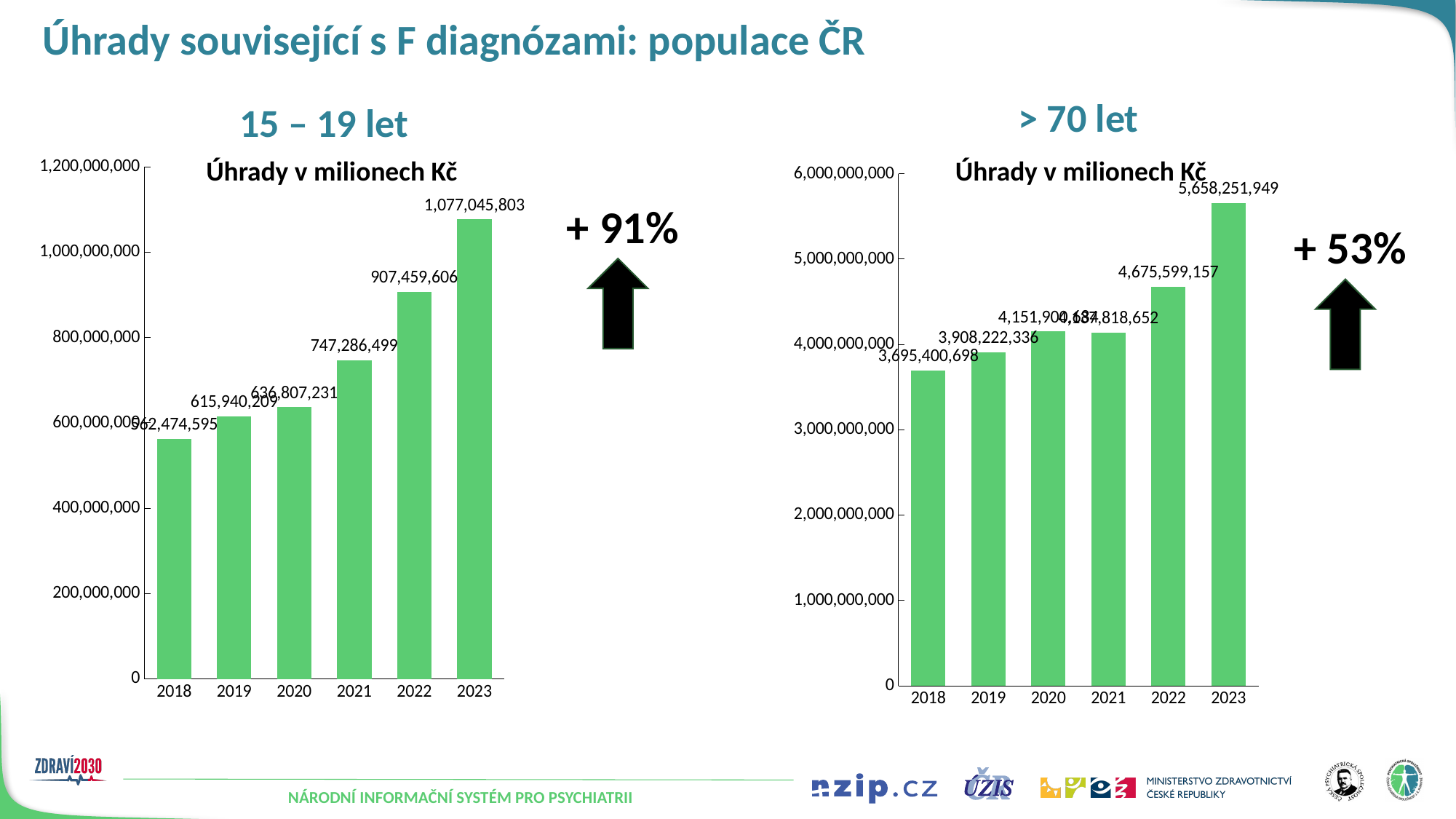
In the '> 70 let' chart, what is the value for 2019? 3,908,222,336 In the '15 – 19 let' chart, which is larger, the value for 2019 or the value for 2022? 2022 In the '> 70 let' chart, is the value for 2018 greater or less than 4,000,000,000? less In the '15 – 19 let' chart, what is the value for 2021? 747,286,499 How many years are shown on the x axis of the '15 – 19 let' chart? 6 In the '15 – 19 let' chart, what is the value for 2023? 1,077,045,803 In the '> 70 let' chart, what is the value for 2022? 4,675,599,157 In the '15 – 19 let' chart, what is the difference between the 2023 and 2022 values? 169,586,197 In the '> 70 let' chart, what is the difference between the 2023 and 2022 values? 982,652,792 In the '15 – 19 let' chart, which year has the lowest value? 2018 What percentage increase is shown next to the '> 70 let' chart? + 53% In the '> 70 let' chart, which year has the highest value? 2023